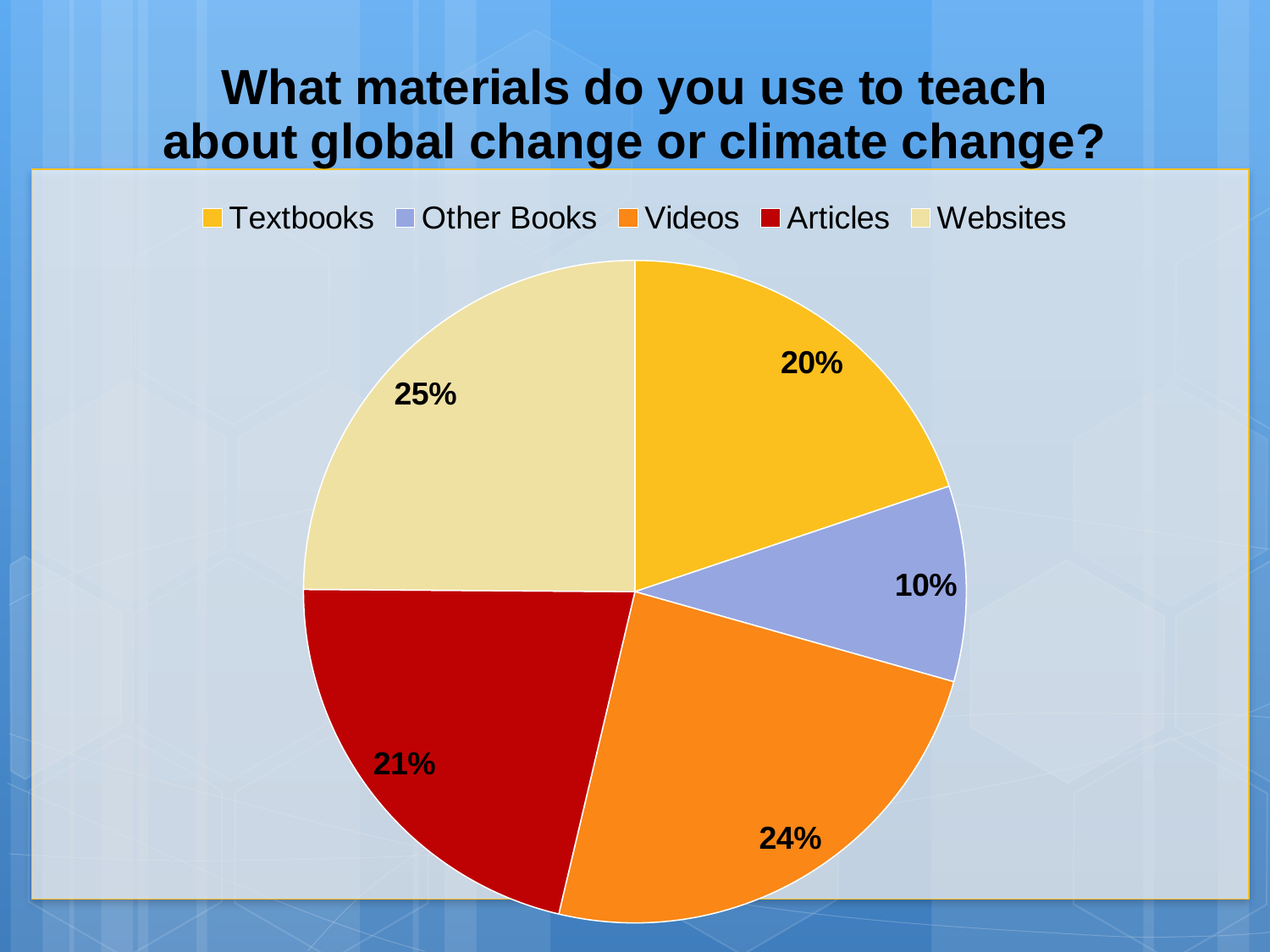
Which category has the largest slice of the pie? Websites Which category has the smallest slice of the pie? Other Books What share of the pie is Textbooks? 20% Which is larger, the share for Videos or the share for Textbooks? Videos What share of the pie is Videos? 24% What is the title of the chart? What materials do you use to teach about global change or climate change? What is the difference between the Websites share and the Other Books share? 15% What share of the pie is Other Books? 10% What kind of chart is shown on the slide? pie chart How many categories does the pie chart show? 5